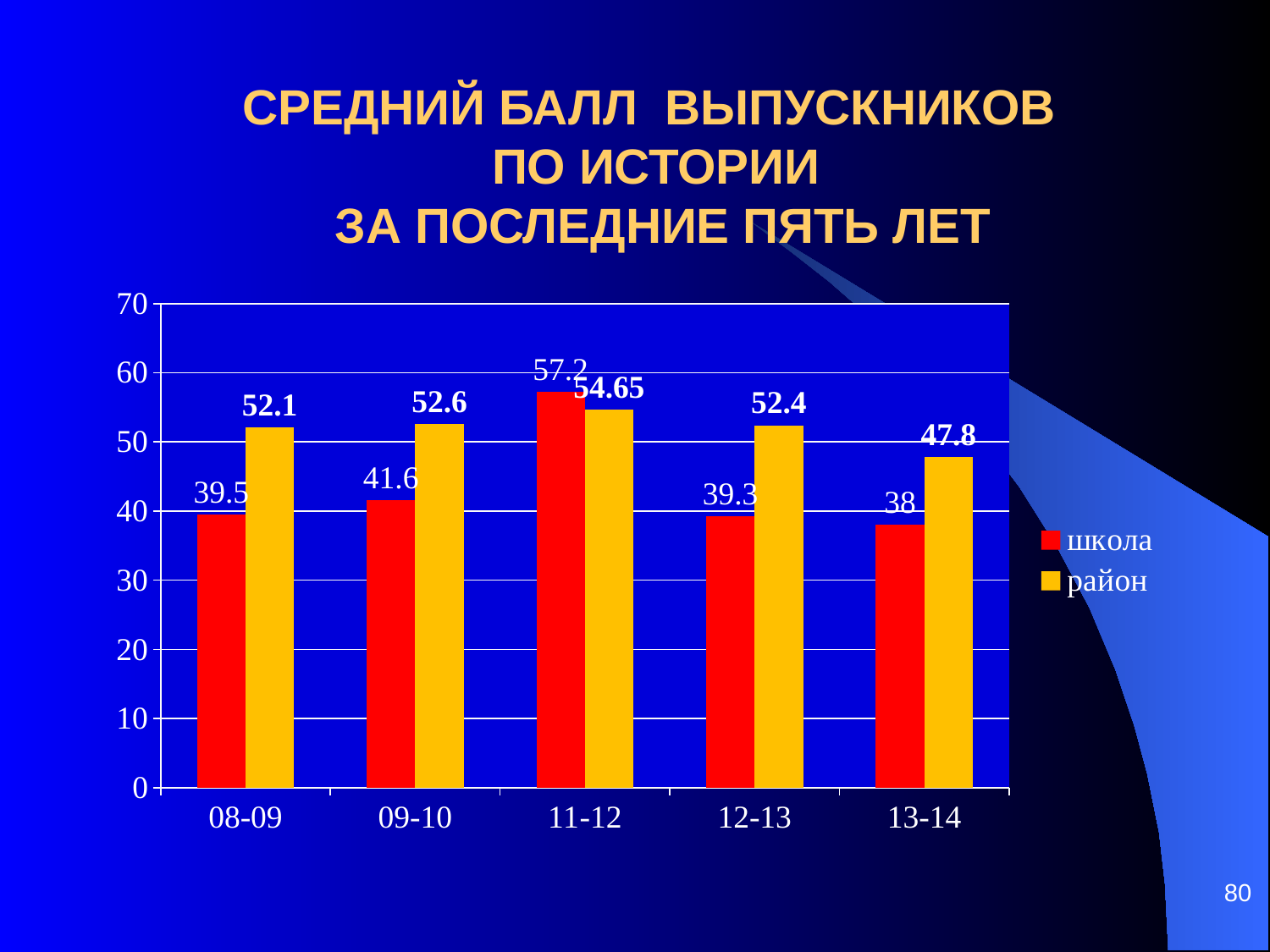
What is the value for школа in 08-09? 39.5 Which is larger in 11-12, школа or район? школа In which year is the школа value lowest? 13-14 What is the value for школа in 11-12? 57.2 In which year is the район value lowest? 13-14 What kind of chart is shown? bar chart Which colour represents район in the legend? yellow In which year is the школа value highest? 11-12 How many years are shown on the x axis? 5 How many series does the legend list? 2 What is the value for район in 13-14? 47.8 What is the difference between район and школа in 08-09? 12.6